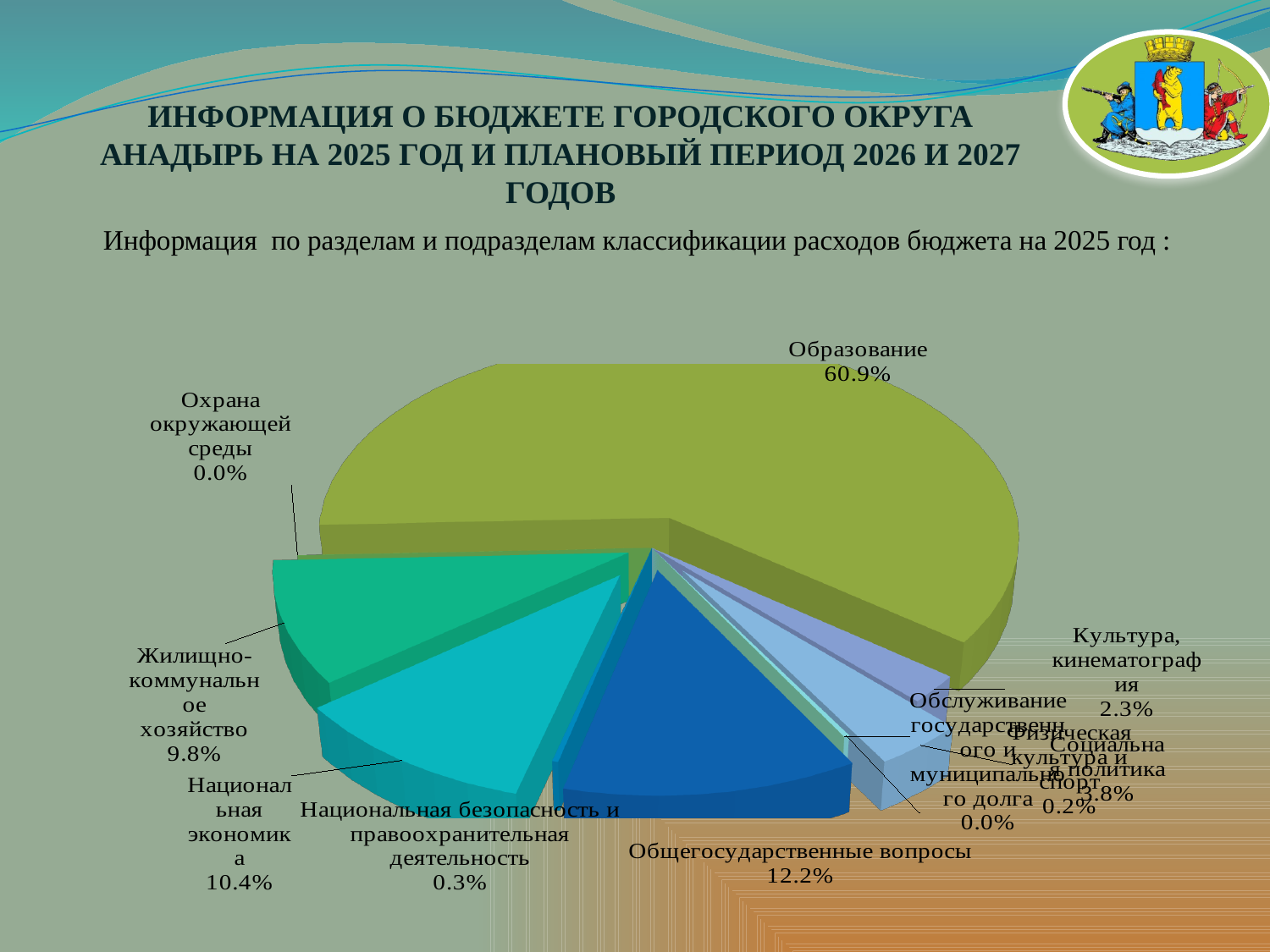
What is the difference between the shares for Общегосударственные вопросы and Национальная экономика? 1.8% What share is shown for Общегосударственные вопросы? 12.2% What share is shown for Культура, кинематография? 2.3% What share of the 2025 budget expenditure goes to Образование? 60.9% What share is shown for Национальная безопасность и правоохранительная деятельность? 0.3% What share is shown for Национальная экономика? 10.4% What share is shown for Социальная политика? 3.8% Which section has the largest share of the pie? Образование What share is shown for Жилищно-коммунальное хозяйство? 9.8% Which is larger: the share for Национальная экономика or the share for Жилищно-коммунальное хозяйство? Национальная экономика How many sections (slices) are labelled on the pie chart? 10 What type of chart is shown on the slide? pie chart